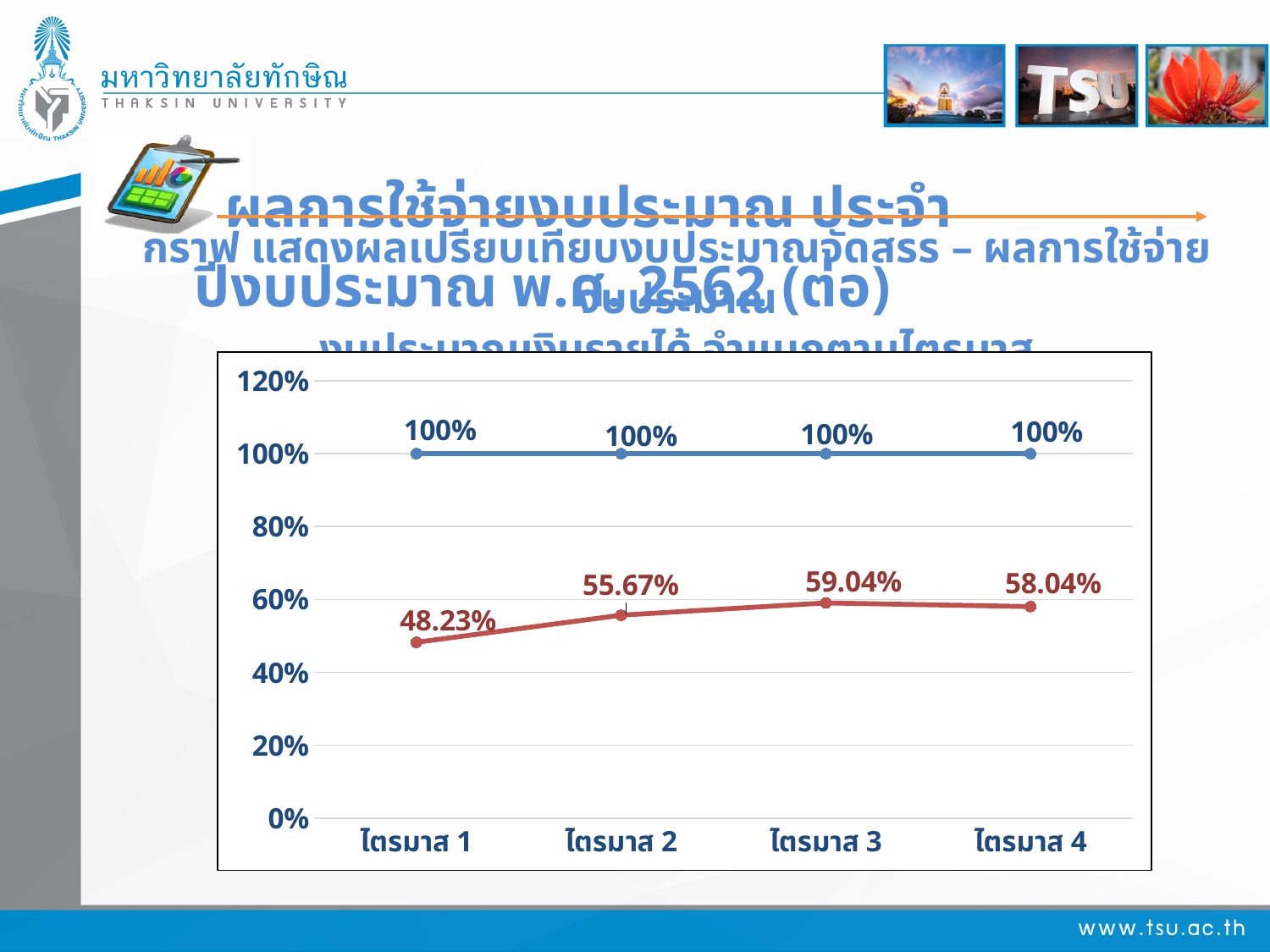
In which quarter does the red line reach its highest value? ไตรมาส 3 What is the value of the red line for ไตรมาส 4? 58.04% What is the value of the red line for ไตรมาส 1? 48.23% What is the difference between the blue line and the red line values for ไตรมาส 1? 51.77% What is the value of the red line for ไตรมาส 2? 55.67% Which is larger for ไตรมาส 3: the red line value or the red line value for ไตรมาส 4? ไตรมาส 3 Does the red line rise or fall from ไตรมาส 1 to ไตรมาส 3? rise What is the value of the red line for ไตรมาส 3? 59.04% What is the value of the blue line for ไตรมาส 2? 100% How many categories (quarters) are shown on the x axis? 4 What type of chart is shown on the slide? line chart In which quarter does the red line have its lowest value? ไตรมาส 1